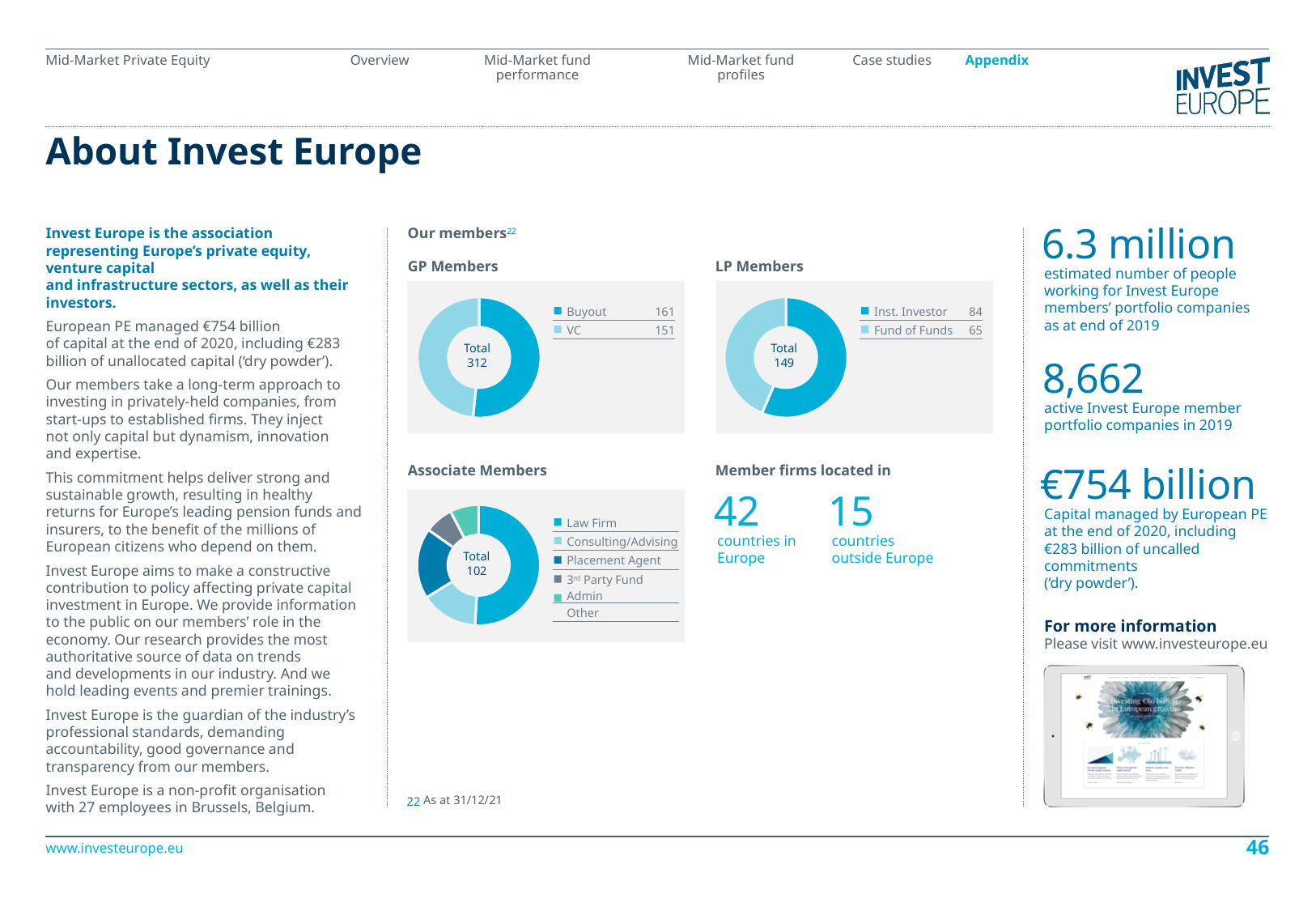
In the GP Members chart, which category is larger, Buyout or VC? Buyout What kind of chart is used for the GP Members, LP Members and Associate Members? Donut (pie) chart In the GP Members chart, what is the difference between Buyout and VC? 10 In the Associate Members chart, how many categories does the legend list? 6 In the LP Members chart, which category is the highest? Inst. Investor In the Associate Members chart, what is the total shown in the centre of the donut? 102 In the GP Members chart, what is the value for VC? 151 In the GP Members chart, what is the value for Buyout? 161 In the GP Members chart, what is the total shown in the centre of the donut? 312 In the LP Members chart, what is the difference between Inst. Investor and Fund of Funds? 19 In the LP Members chart, what is the value for Fund of Funds? 65 In the LP Members chart, what is the value for Inst. Investor? 84